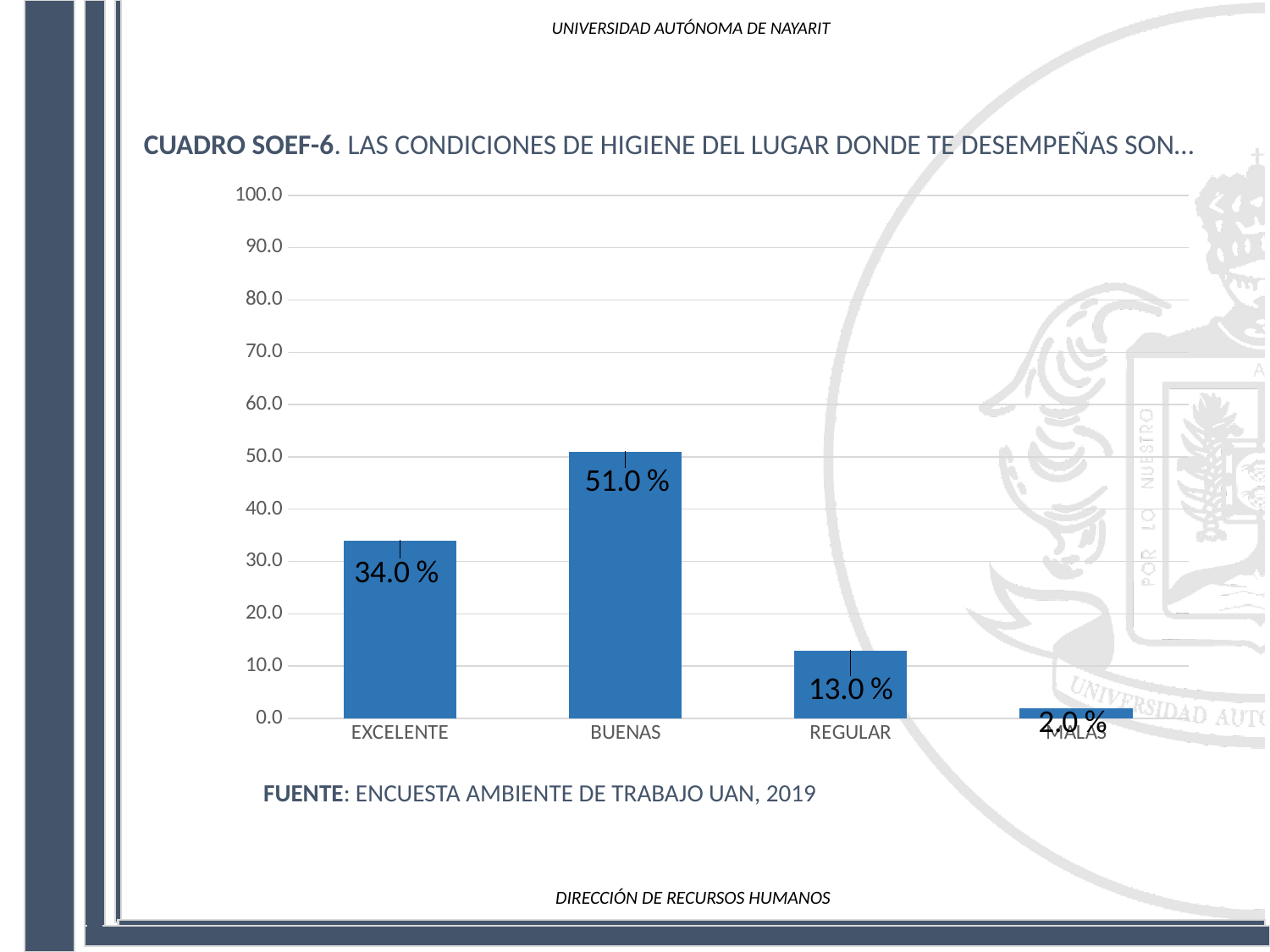
What kind of chart is shown on the slide? bar chart What is the value for REGULAR? 13.0 % What is the value for BUENAS? 51.0 % What source is cited below the chart? ENCUESTA AMBIENTE DE TRABAJO UAN, 2019 What is the difference between the values for BUENAS and EXCELENTE? 17.0 % Which category has the highest value? BUENAS How many categories are shown on the x axis? 4 Which is larger, the value for EXCELENTE or the value for REGULAR? EXCELENTE What is the value for MALAS? 2.0 % Which category has the lowest value? MALAS Is the value for BUENAS greater or less than 50.0? greater What is the value for EXCELENTE? 34.0 %